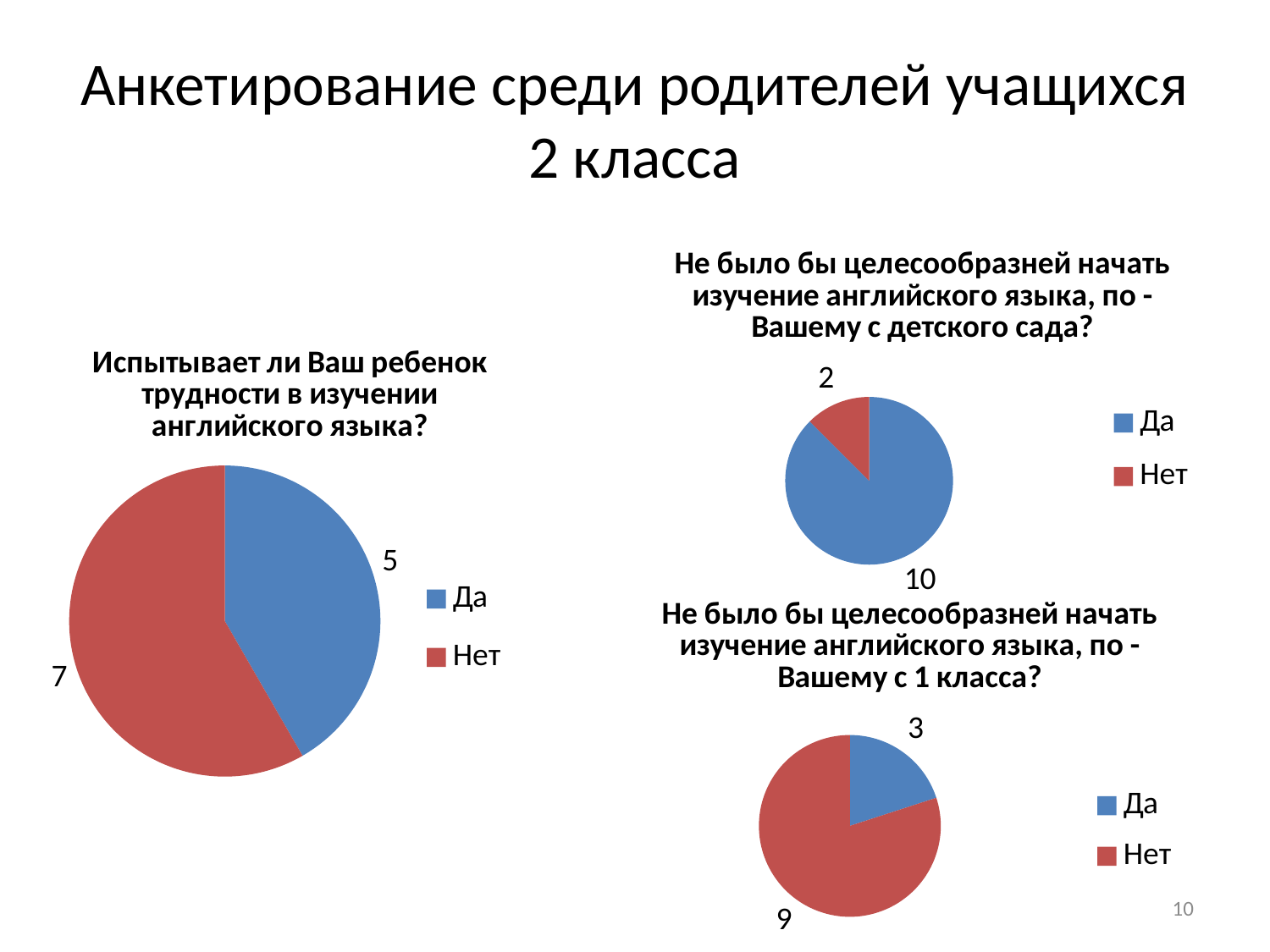
What type of chart is used on this slide? Pie chart In the top-right chart about starting English from kindergarten ("с детского сада"), what is the value for "Да"? 10 In the left chart "Испытывает ли Ваш ребенок трудности в изучении английского языка?", what is the value for "Нет"? 7 In the left chart "Испытывает ли Ваш ребенок трудности в изучении английского языка?", what is the value for "Да"? 5 In the left chart "Испытывает ли Ваш ребенок трудности в изучении английского языка?", which category is the largest? Нет In the bottom-right chart about starting English from 1st grade ("с 1 класса"), what is the value for "Нет"? 9 How many charts are shown on the slide? 3 In the top-right chart about starting English from kindergarten ("с детского сада"), what is the value for "Нет"? 2 In the bottom-right chart about starting English from 1st grade ("с 1 класса"), what is the value for "Да"? 3 In the top-right chart about starting English from kindergarten, what share of the pie does "Да" represent? 10 out of 12 In the top-right chart about starting English from kindergarten, which category is the smallest? Нет In the bottom-right chart about starting English from 1st grade, what is the difference between "Нет" and "Да"? 6